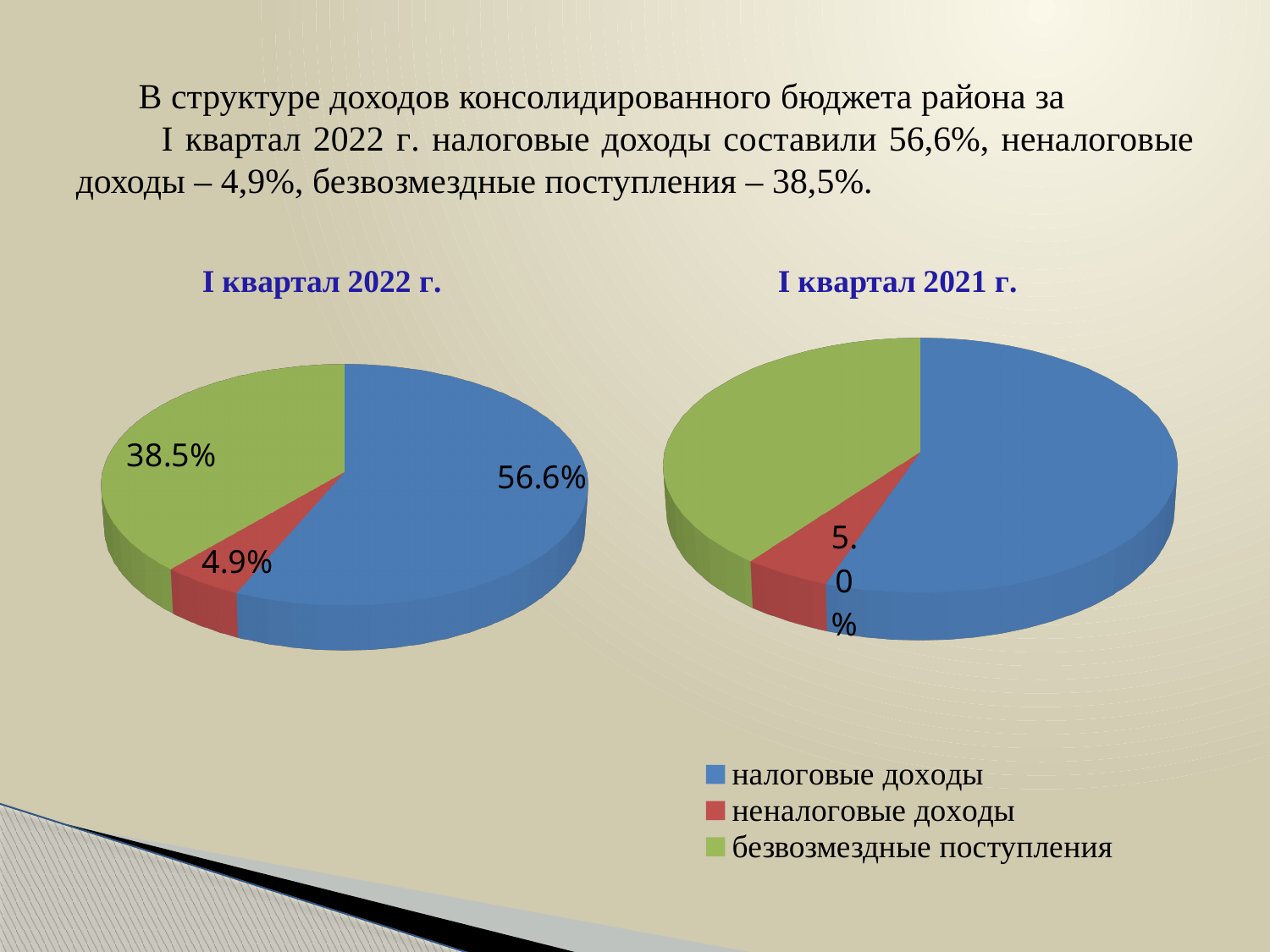
In the chart titled "I квартал 2022 г.", what share is shown for неналоговые доходы? 4.9% In the chart titled "I квартал 2021 г.", what share is labelled for неналоговые доходы? 5.0% In the chart titled "I квартал 2022 г.", how many slices does the pie have? 3 In the chart titled "I квартал 2021 г.", which category has the largest slice? налоговые доходы What type of chart is used on this slide for "I квартал 2021 г."? pie chart In the chart titled "I квартал 2022 г.", what share is shown for безвозмездные поступления? 38.5% In the chart titled "I квартал 2022 г.", which category has the smallest slice? неналоговые доходы In the chart titled "I квартал 2022 г.", how many percentage points larger is налоговые доходы than безвозмездные поступления? 18.1% How many entries does the legend on the slide list? 3 In the chart titled "I квартал 2022 г.", what share is shown for налоговые доходы? 56.6% In the chart titled "I квартал 2022 г.", which is larger: безвозмездные поступления or неналоговые доходы? безвозмездные поступления In the chart titled "I квартал 2022 г.", which category has the largest slice? налоговые доходы